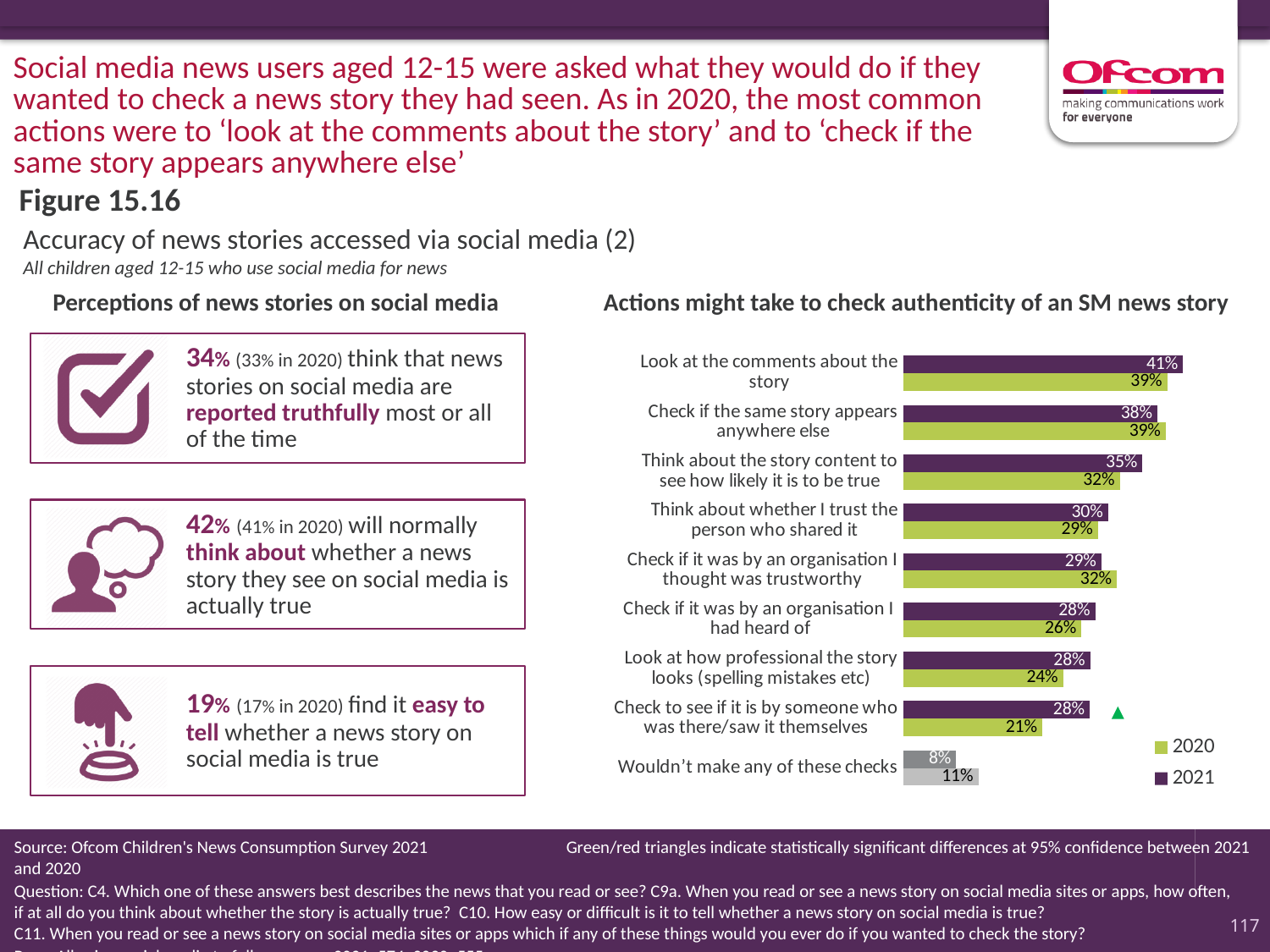
In the 'Actions might take to check authenticity of an SM news story' chart, what is the 2021 value for 'Check to see if it is by someone who was there/saw it themselves'? 28% What type of chart is used for 'Actions might take to check authenticity of an SM news story'? Bar chart In the 'Actions might take to check authenticity of an SM news story' chart, what is the 2021 value for 'Look at the comments about the story'? 41% In the 'Actions might take to check authenticity of an SM news story' chart, which is larger for 'Look at how professional the story looks (spelling mistakes etc)': the 2020 value or the 2021 value? 2021 In the 'Actions might take to check authenticity of an SM news story' chart, what is the difference between the 2021 and 2020 values for 'Check to see if it is by someone who was there/saw it themselves'? 7 percentage points In the 'Actions might take to check authenticity of an SM news story' chart, what is the difference between the 2020 and 2021 values for 'Check if it was by an organisation I thought was trustworthy'? 3 percentage points In the 'Actions might take to check authenticity of an SM news story' chart, which is larger for 'Wouldn't make any of these checks': the 2020 value or the 2021 value? 2020 In the 'Actions might take to check authenticity of an SM news story' chart, what is the 2020 value for 'Check if the same story appears anywhere else'? 39% In the 'Actions might take to check authenticity of an SM news story' chart, which action has the highest 2021 value? Look at the comments about the story In the 'Actions might take to check authenticity of an SM news story' chart, which category has the lowest 2020 value? Wouldn't make any of these checks How many action categories are shown in the 'Actions might take to check authenticity of an SM news story' chart? 9 How many series does the legend of the 'Actions might take to check authenticity of an SM news story' chart list? 2